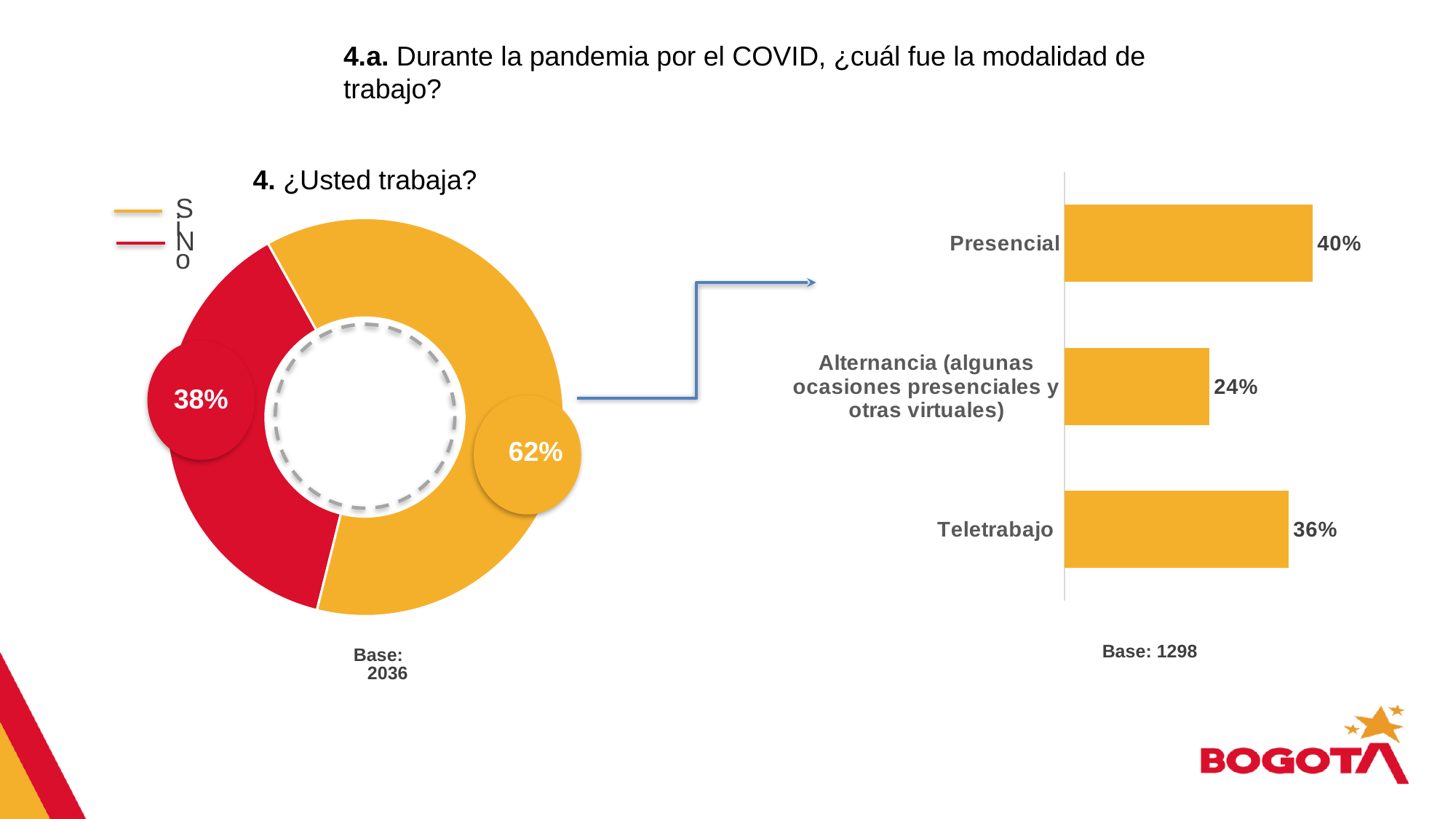
In the donut chart '4. ¿Usted trabaja?', what share of respondents answered Sí? 62% In the bar chart on the right (modalidad de trabajo), what is the value for Teletrabajo? 36% In the bar chart on the right (modalidad de trabajo), what is the difference in percentage points between Presencial and Teletrabajo? 4 In the bar chart on the right (modalidad de trabajo), which category has the lowest value? Alternancia (algunas ocasiones presenciales y otras virtuales) In the donut chart '4. ¿Usted trabaja?', what share of respondents answered No? 38% In the donut chart '4. ¿Usted trabaja?', what colour represents the No answer? Red What kind of chart is shown on the right side of the slide (modalidad de trabajo)? Bar chart In the bar chart on the right (modalidad de trabajo), what is the value for Alternancia (algunas ocasiones presenciales y otras virtuales)? 24% In the bar chart on the right (modalidad de trabajo), what is the value for Presencial? 40% In the donut chart '4. ¿Usted trabaja?', how many series does the legend list? 2 In the donut chart '4. ¿Usted trabaja?', which answer has the larger share, Sí or No? Sí In the donut chart '4. ¿Usted trabaja?', what is the difference in percentage points between the Sí and No shares? 24